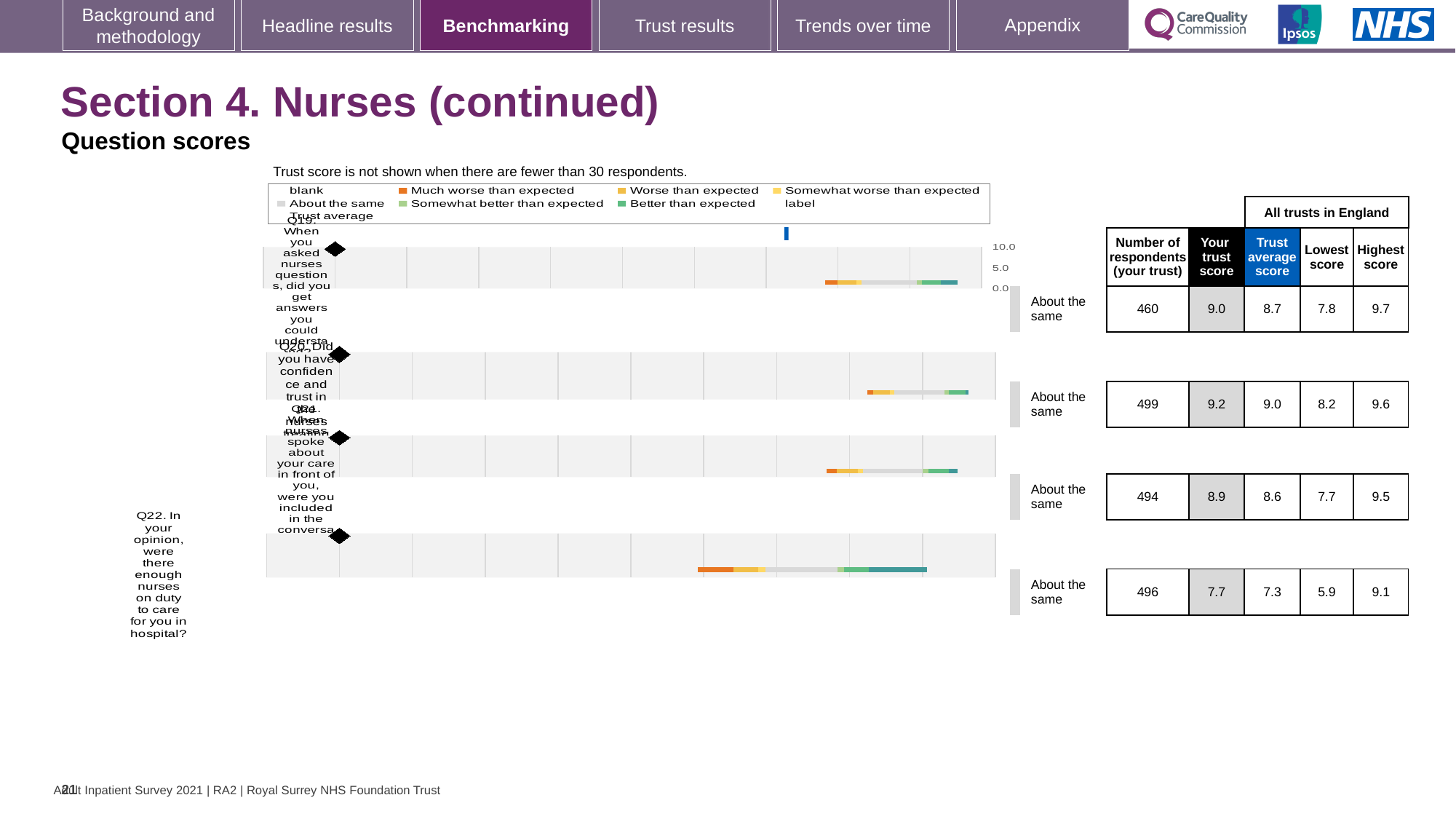
For Q22, what is the difference between the highest score and the lowest score across all trusts in England? 3.2 What is the trust average score for Q19 (when you asked nurses questions, did you get answers you could understand)? 8.7 For Q22, how much higher is your trust score than the trust average score? 0.4 What benchmark category label is shown for each of the four questions? About the same Which question has the highest 'Your trust score' on this slide? Q20 How many respondents from your trust answered Q22? 496 What is the 'Your trust score' for Q22 (were there enough nurses on duty to care for you in hospital)? 7.7 Which question has the lowest 'Your trust score' on this slide? Q22 What is the lowest score across all trusts in England for Q20 (confidence and trust in the nurses)? 8.2 For Q19, which is larger: your trust score or the trust average score? Your trust score What is the highest score across all trusts in England for Q21 (were you included in the conversation)? 9.5 How many questions are plotted on this slide's chart? 4